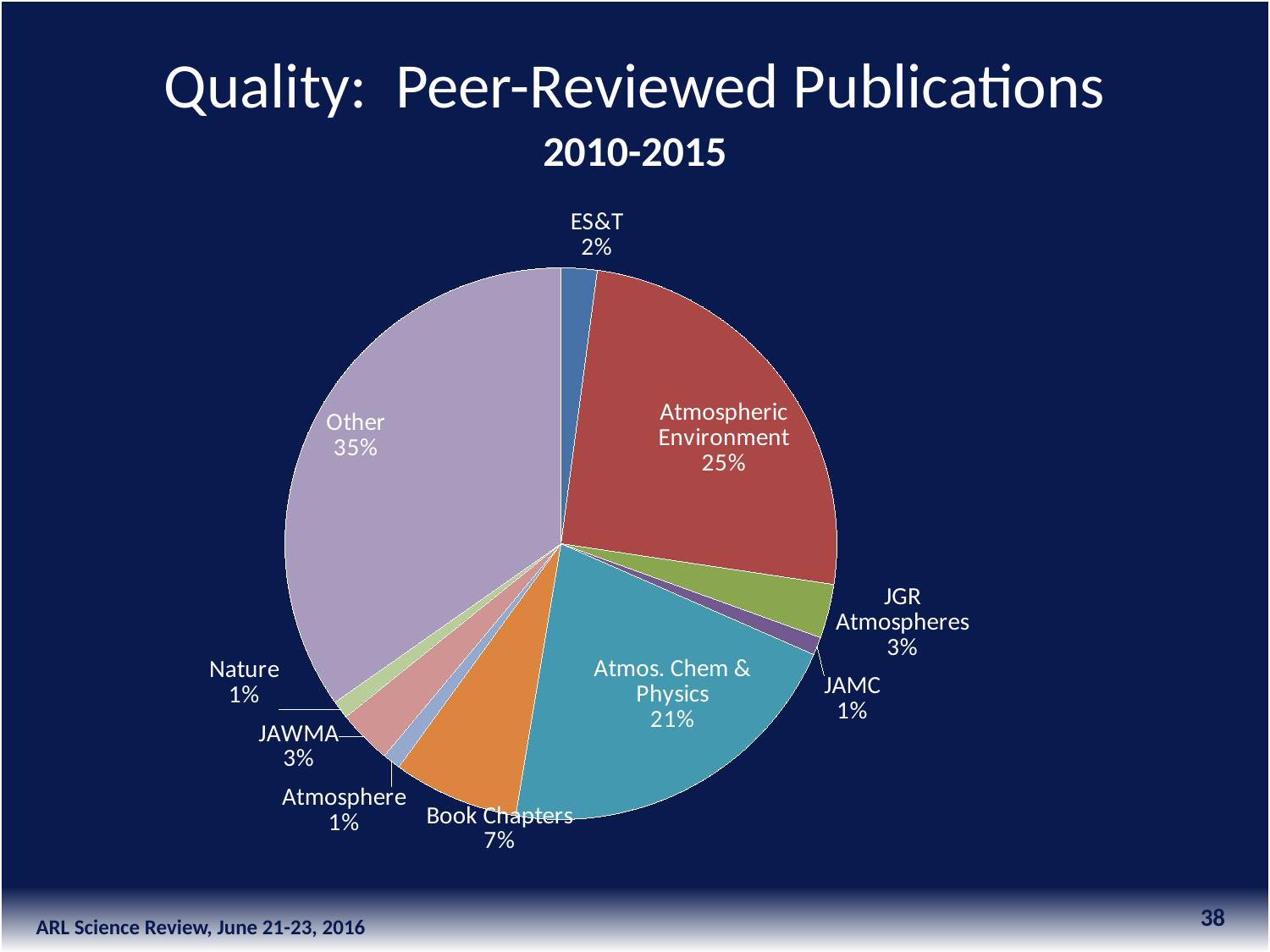
What is the difference in percentage points between Other and Atmospheric Environment? 10 What is the combined share of Atmospheric Environment and Atmos. Chem & Physics? 46% What share of the pie does Atmospheric Environment have? 25% How many categories are shown in the pie chart? 10 What percentage is shown for Atmos. Chem & Physics? 21% Which category has the largest slice of the pie? Other What percentage is shown for Book Chapters? 7% Which is larger, the share for JGR Atmospheres or the share for Book Chapters? Book Chapters What kind of chart is shown on the slide? pie chart What time period does the chart's subtitle cover? 2010-2015 What percentage is shown for ES&T? 2% What percentage is shown for JAWMA? 3%